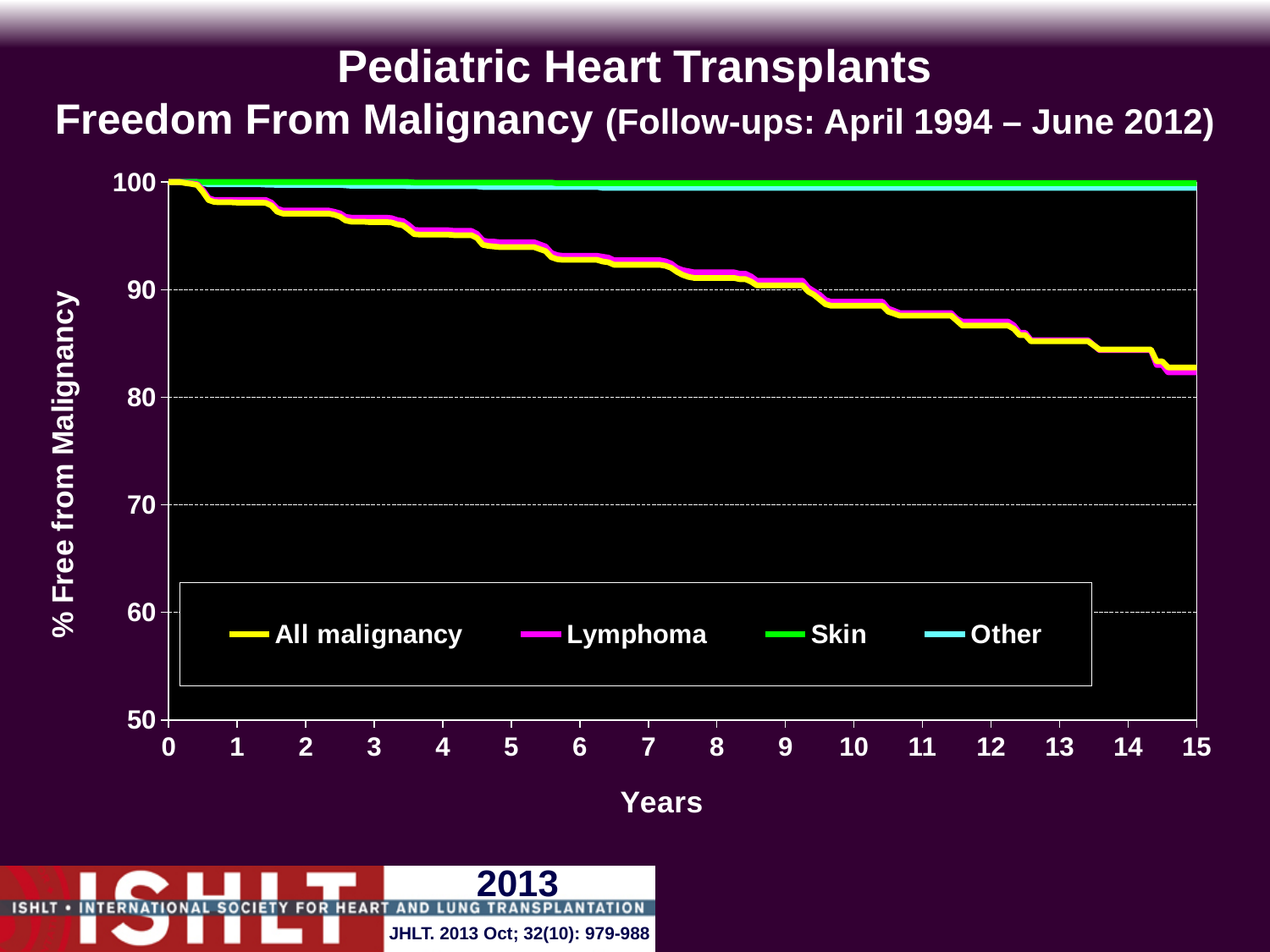
Which colour represents the Lymphoma series in the legend? magenta Is the value for Lymphoma at year 15 greater or less than 90? less What is the label of the x axis? Years Is the value for All malignancy at year 10 greater or less than 90? less At year 15, which is higher: the Skin series or the All malignancy series? Skin Does the All malignancy line rise or fall as years increase? fall Is the value for All malignancy at year 5 greater or less than 90? greater What kind of chart is shown on the slide? line chart How many series does the legend list? 4 What is the title of the chart? Pediatric Heart Transplants Freedom From Malignancy